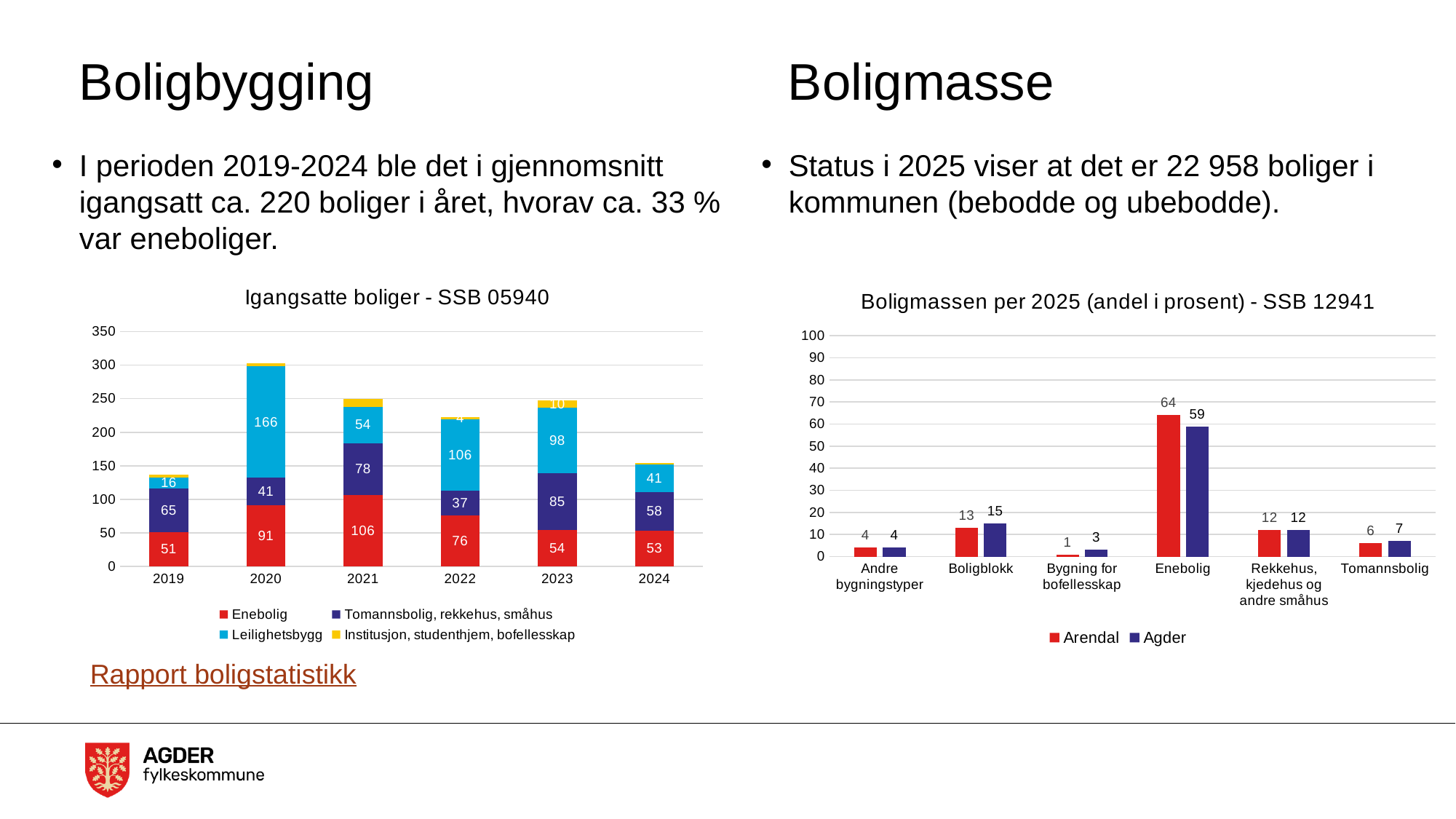
In the chart 'Boligmassen per 2025 (andel i prosent) - SSB 12941', how many categories are shown on the x axis? 6 In the chart 'Igangsatte boliger - SSB 05940', what is the value for Enebolig in 2021? 106 What kind of chart is 'Boligmassen per 2025 (andel i prosent) - SSB 12941'? Bar chart In the chart 'Boligmassen per 2025 (andel i prosent) - SSB 12941', what is the difference between Arendal and Agder for Enebolig? 5 In the chart 'Igangsatte boliger - SSB 05940', what is the value for Leilighetsbygg in 2020? 166 In the chart 'Igangsatte boliger - SSB 05940', is the total for 2024 greater or less than 200? less In the chart 'Igangsatte boliger - SSB 05940', what is the difference between the Enebolig values for 2021 and 2019? 55 In the chart 'Boligmassen per 2025 (andel i prosent) - SSB 12941', which is larger for Boligblokk, Arendal or Agder? Agder In the chart 'Boligmassen per 2025 (andel i prosent) - SSB 12941', what is the value for Arendal in the Enebolig category? 64 In the chart 'Boligmassen per 2025 (andel i prosent) - SSB 12941', which category has the lowest value for Arendal? Bygning for bofellesskap In the chart 'Igangsatte boliger - SSB 05940', which year has the tallest stacked bar? 2020 In the chart 'Igangsatte boliger - SSB 05940', how many series does the legend list? 4